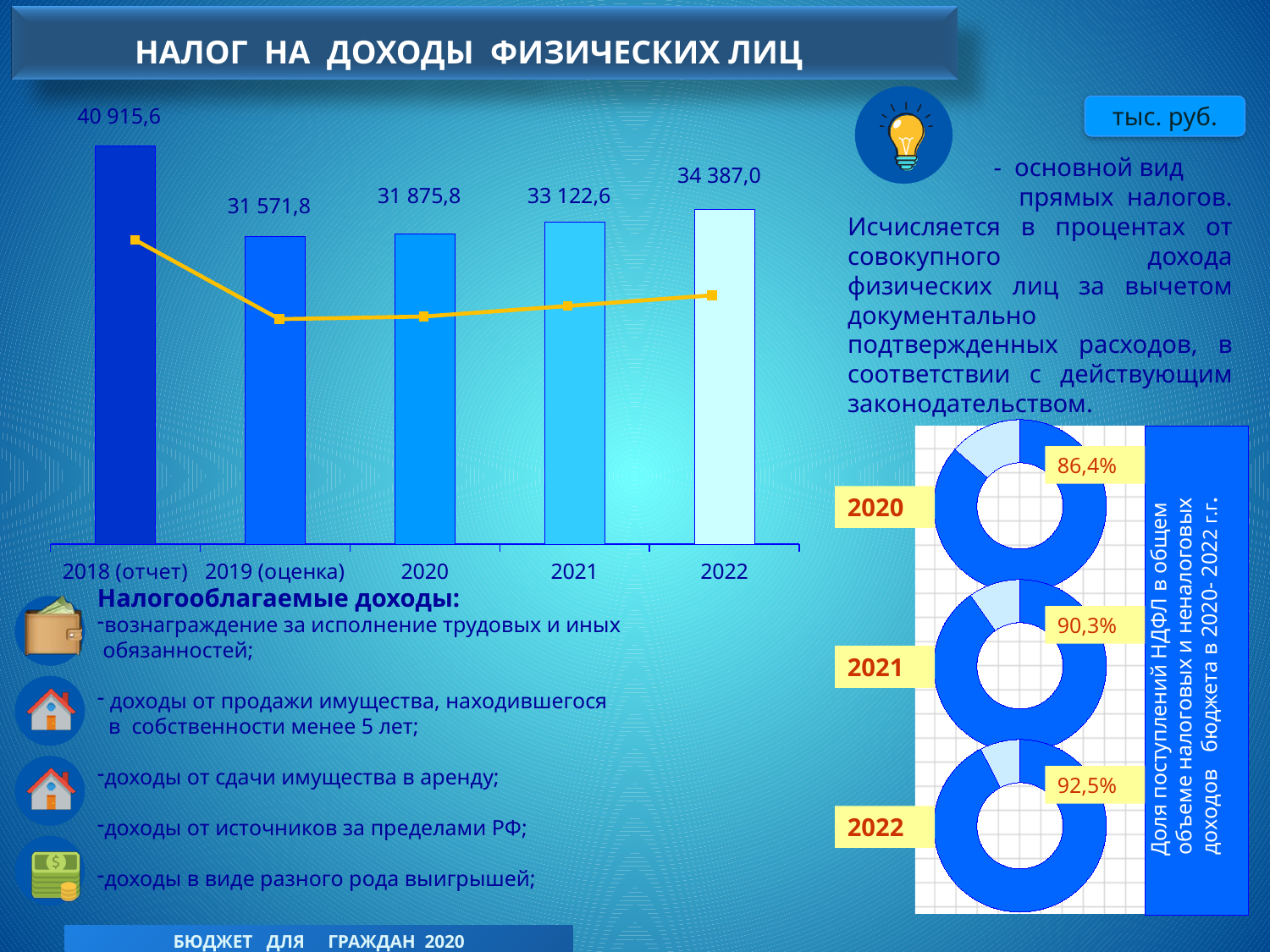
In the bar chart on the left, do the values rise or fall from 2019 (оценка) to 2022? rise In the bar chart on the left, which year has the highest value? 2018 (отчет) What type of chart is the chart on the left of the slide? bar chart In the bar chart on the left, what is the value for 2018 (отчет)? 40 915,6 In the donut charts on the right, what share is shown for 2021? 90,3% How many years are shown on the x axis of the bar chart on the left? 5 In the bar chart on the left, what is the value for 2020? 31 875,8 In the bar chart on the left, which is larger: the value for 2021 or the value for 2020? 2021 In the bar chart on the left, what is the value for 2022? 34 387,0 In the donut charts on the right, which year has the highest share? 2022 In the bar chart on the left, what is the difference between the values for 2018 (отчет) and 2019 (оценка)? 9 343,8 In the bar chart on the left, which year has the lowest value? 2019 (оценка)